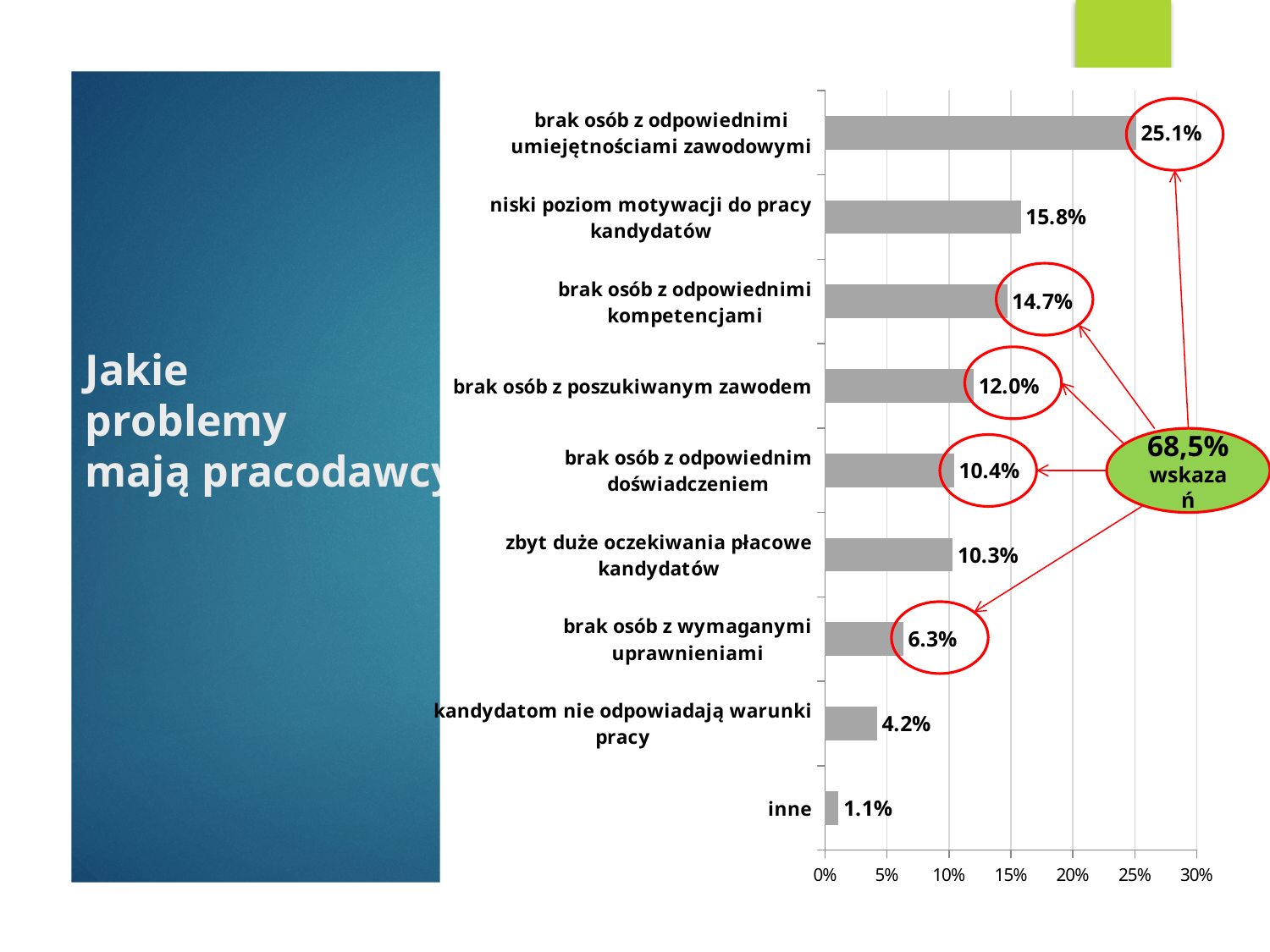
What kind of chart is shown on the slide? bar chart Which is larger: the value for "zbyt duże oczekiwania płacowe kandydatów" or the value for "kandydatom nie odpowiadają warunki pracy"? zbyt duże oczekiwania płacowe kandydatów What is the total of the values for "brak osób z odpowiednimi umiejętnościami zawodowymi" and "inne"? 26.2% What is the value for "brak osób z odpowiednimi umiejętnościami zawodowymi"? 25.1% Which category has the highest value? brak osób z odpowiednimi umiejętnościami zawodowymi Which category has the lowest value? inne Is the value for "brak osób z odpowiednim doświadczeniem" greater or less than 15%? less What is the value for "niski poziom motywacji do pracy kandydatów"? 15.8% What is the value for "brak osób z wymaganymi uprawnieniami"? 6.3% How many categories are shown in the chart? 9 What percentage is written in the green oval on the chart? 68,5% What is the difference between the values for "brak osób z odpowiednimi kompetencjami" and "brak osób z poszukiwanym zawodem"? 2.7%